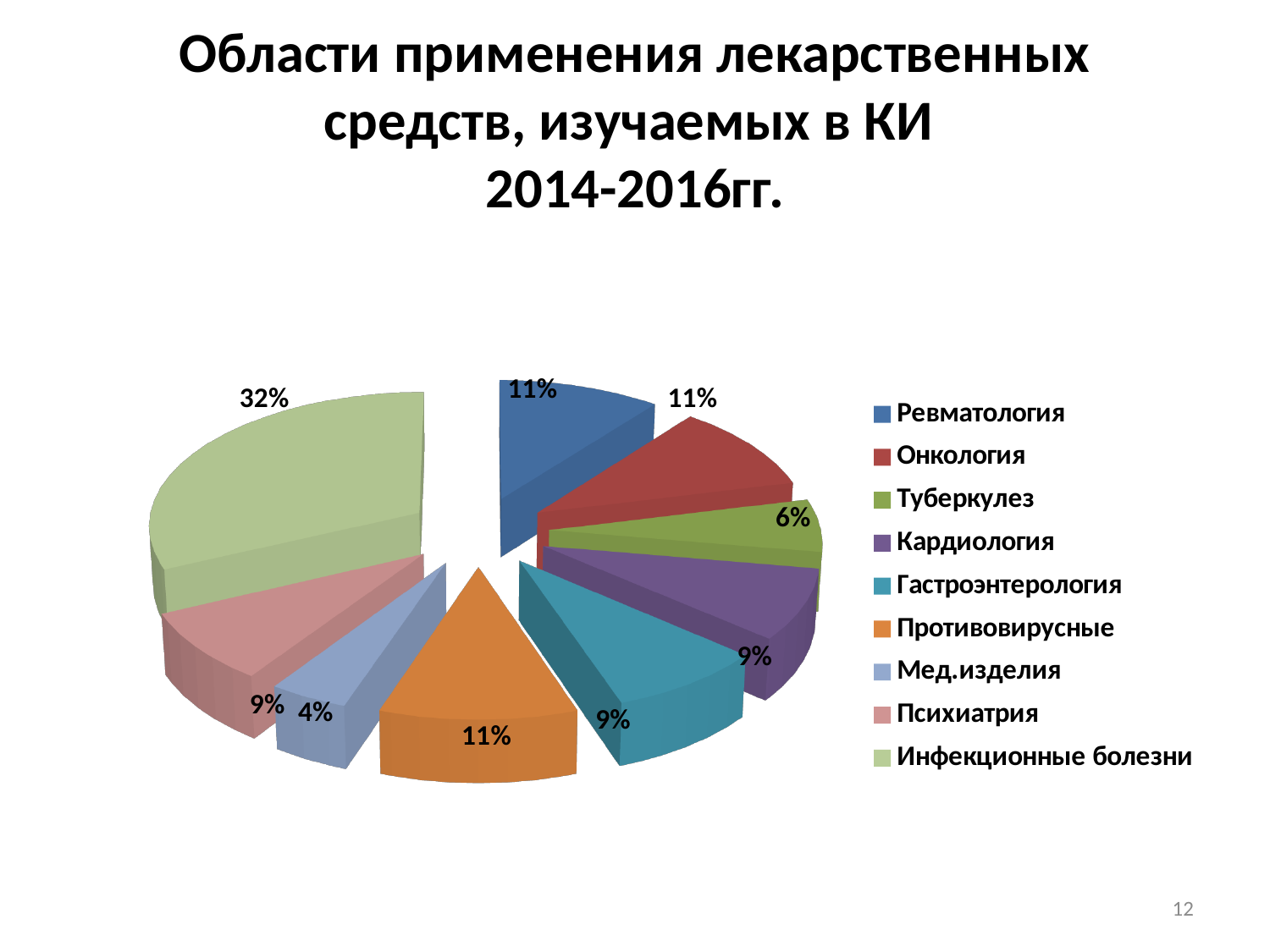
Which category has the largest share of the pie? Инфекционные болезни What type of chart is shown on the slide? Pie chart What is the value for Мед.изделия? 4% What share of the pie does Инфекционные болезни have? 32% What is the value for Туберкулез? 6% Which category has the smallest share of the pie? Мед.изделия How many categories does the legend list? 9 What is the difference between the shares of Инфекционные болезни and Ревматология? 21% What is the value for Кардиология? 9% What is the value for Противовирусные? 11% Which is larger, the share for Онкология or the share for Туберкулез? Онкология What is the title of the chart on the slide? Области применения лекарственных средств, изучаемых в КИ 2014-2016гг.